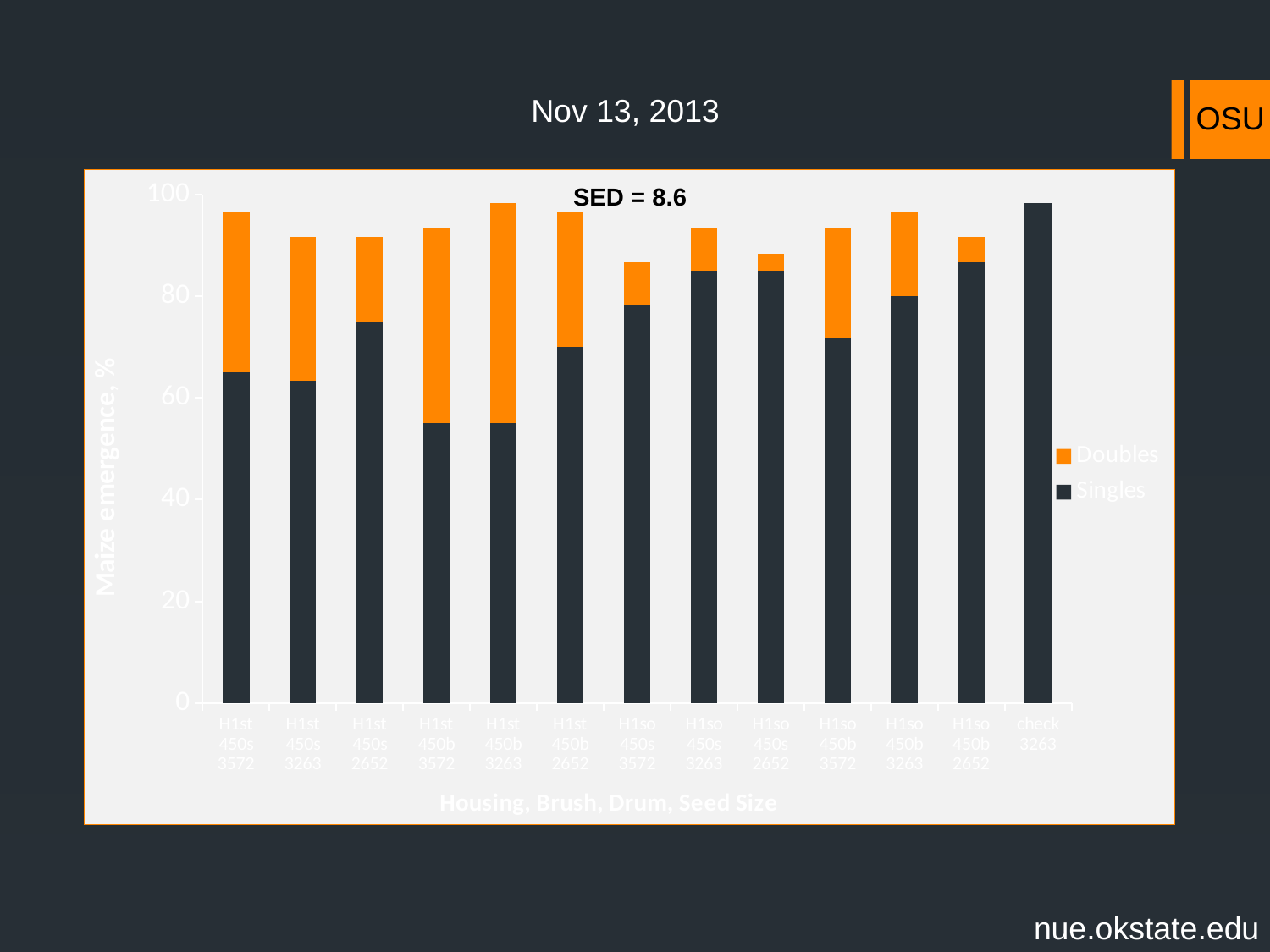
Is the Singles value for H1st 450b 3572 greater or less than 60? less Which category has the highest Singles value? check 3263 Which category has a taller total stacked bar, H1so 450s 3572 or H1st 450b 3263? H1st 450b 3263 How many categories are plotted along the x axis? 13 What kind of chart is shown on the slide? Stacked bar chart What are the two series named in the legend? Doubles and Singles How many series does the legend list? 2 Is the Singles value for check 3263 greater or less than 80? greater What is the y-axis title of the chart? Maize emergence, % Which category has the largest Doubles segment? H1st 450b 3263 Is the Singles value for H1so 450s 3263 greater or less than 80? greater Which has the larger Singles value, H1st 450s 2652 or H1st 450s 3263? H1st 450s 2652